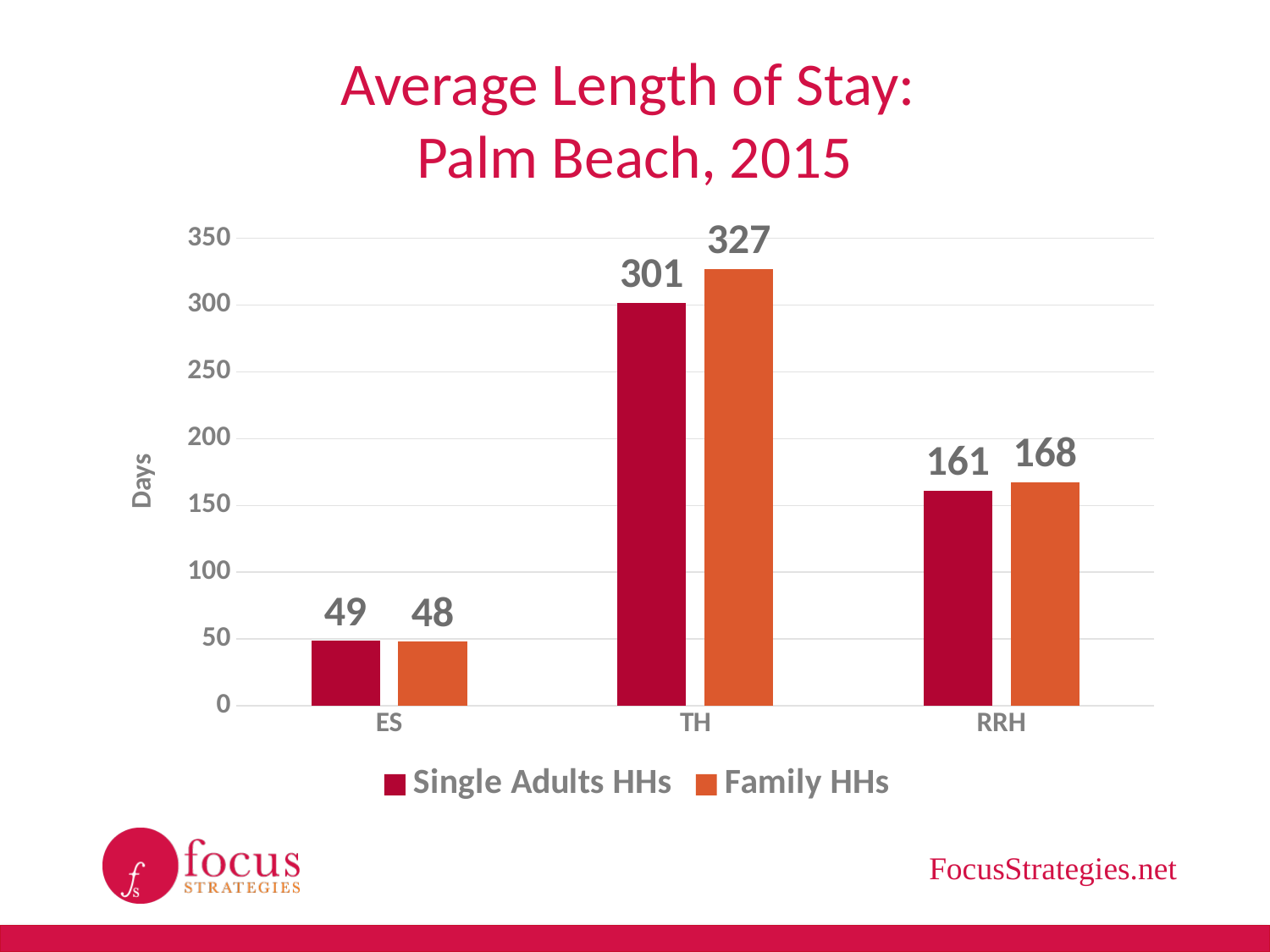
What is the difference between Family HHs and Single Adults HHs in TH? 26 Which is larger: Single Adults HHs in RRH or Family HHs in RRH? Family HHs in RRH What is the difference between Single Adults HHs in RRH and Single Adults HHs in ES? 112 Which category has the lowest value for Single Adults HHs? ES What is the average length of stay for Single Adults HHs in TH? 301 Which category has the highest value for Family HHs? TH What is the value for Family HHs in ES? 48 How many series does the legend list? 2 What kind of chart is shown on the slide? Bar chart How many categories are shown on the x axis? 3 What is the average length of stay for Family HHs in RRH? 168 What is the label of the vertical axis? Days